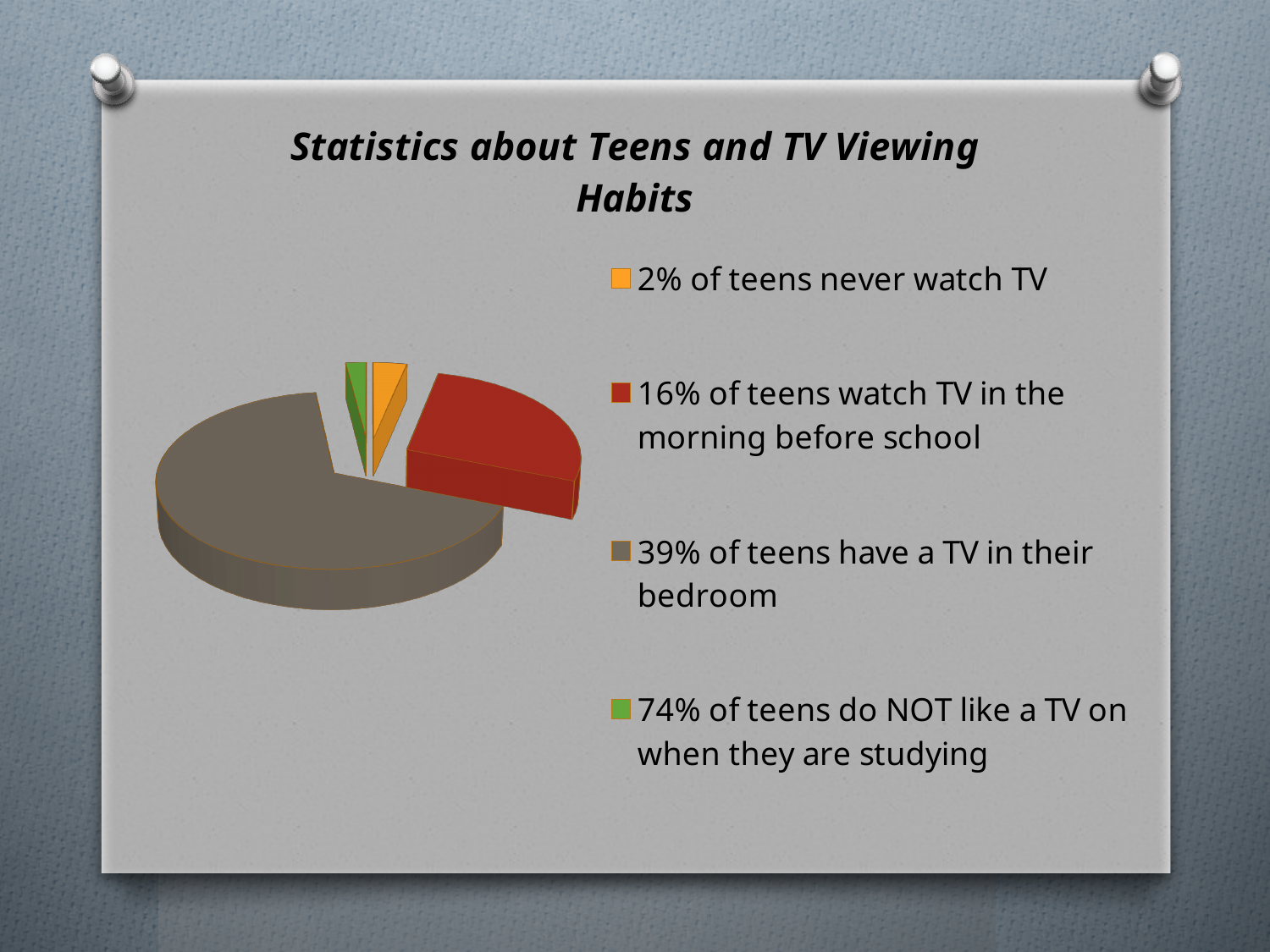
What is the title of the slide containing the pie chart? Statistics about Teens and TV Viewing Habits What kind of chart is shown on the slide? pie chart Which slice is larger in the pie chart: the gray slice or the red slice? the gray slice Which slice is larger in the pie chart: the gray slice or the green slice? the gray slice Which legend entry corresponds to the largest slice of the pie chart? 39% of teens have a TV in their bedroom How many entries does the chart's legend list? 4 What does the legend entry for the green slice of the pie chart say? 74% of teens do NOT like a TV on when they are studying How many slices does the pie chart have? 4 Which slice is larger in the pie chart: the red slice or the orange slice? the red slice